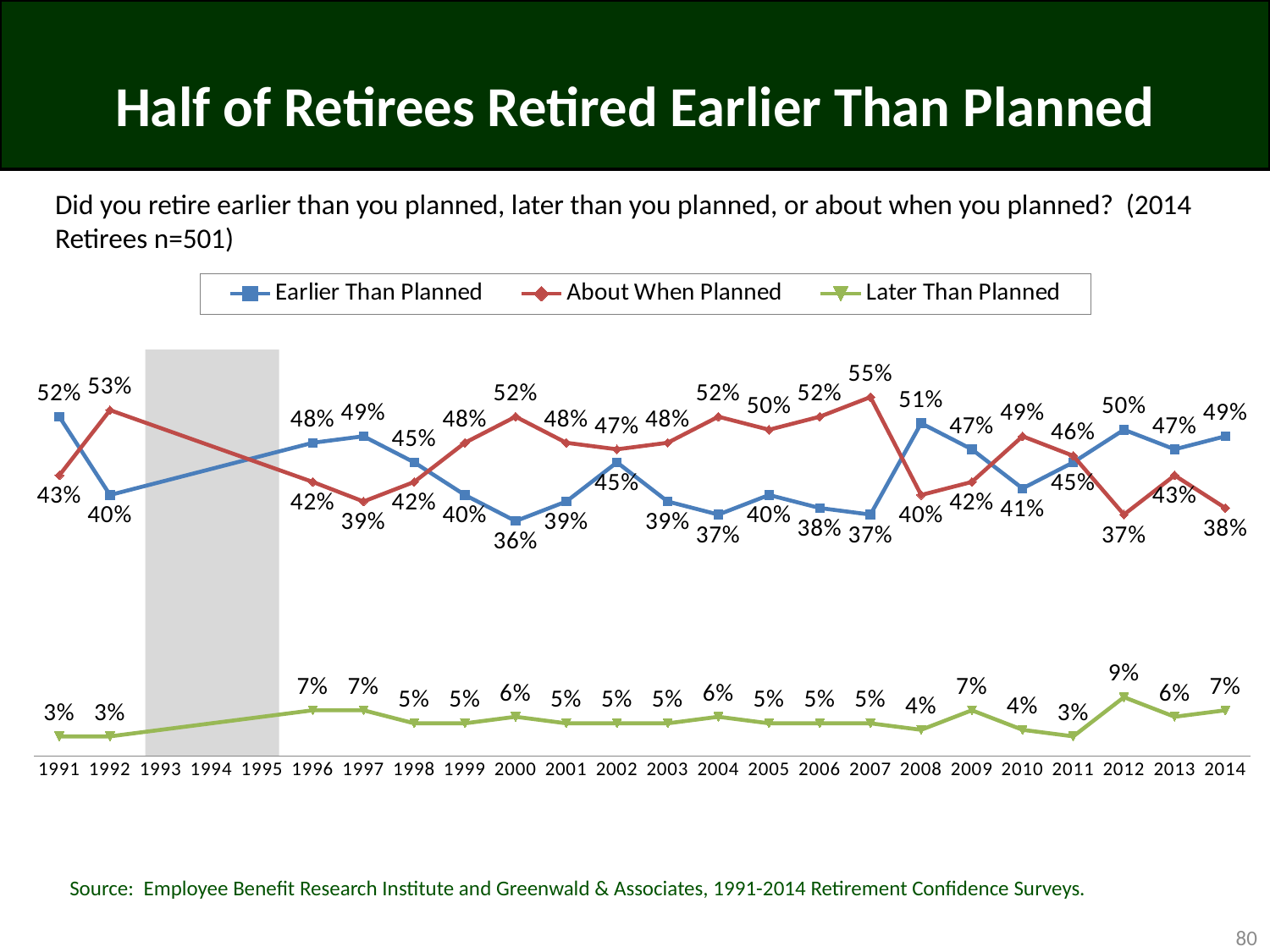
How many years are labeled on the x axis? 24 In which year does the About When Planned series reach its highest value? 2007 In which year does the Earlier Than Planned series reach its lowest value? 2000 What is the value for Later Than Planned in 2012? 9% In 2008, which is larger: Earlier Than Planned or About When Planned? Earlier Than Planned What is the value for About When Planned in 2007? 55% How many series does the legend list? 3 What is the value for Earlier Than Planned in 2014? 49% Which series is shown in green? Later Than Planned What is the difference between Earlier Than Planned and About When Planned in 2014? 11 percentage points What is the value for Earlier Than Planned in 2000? 36% What type of chart is shown on the slide? Line chart